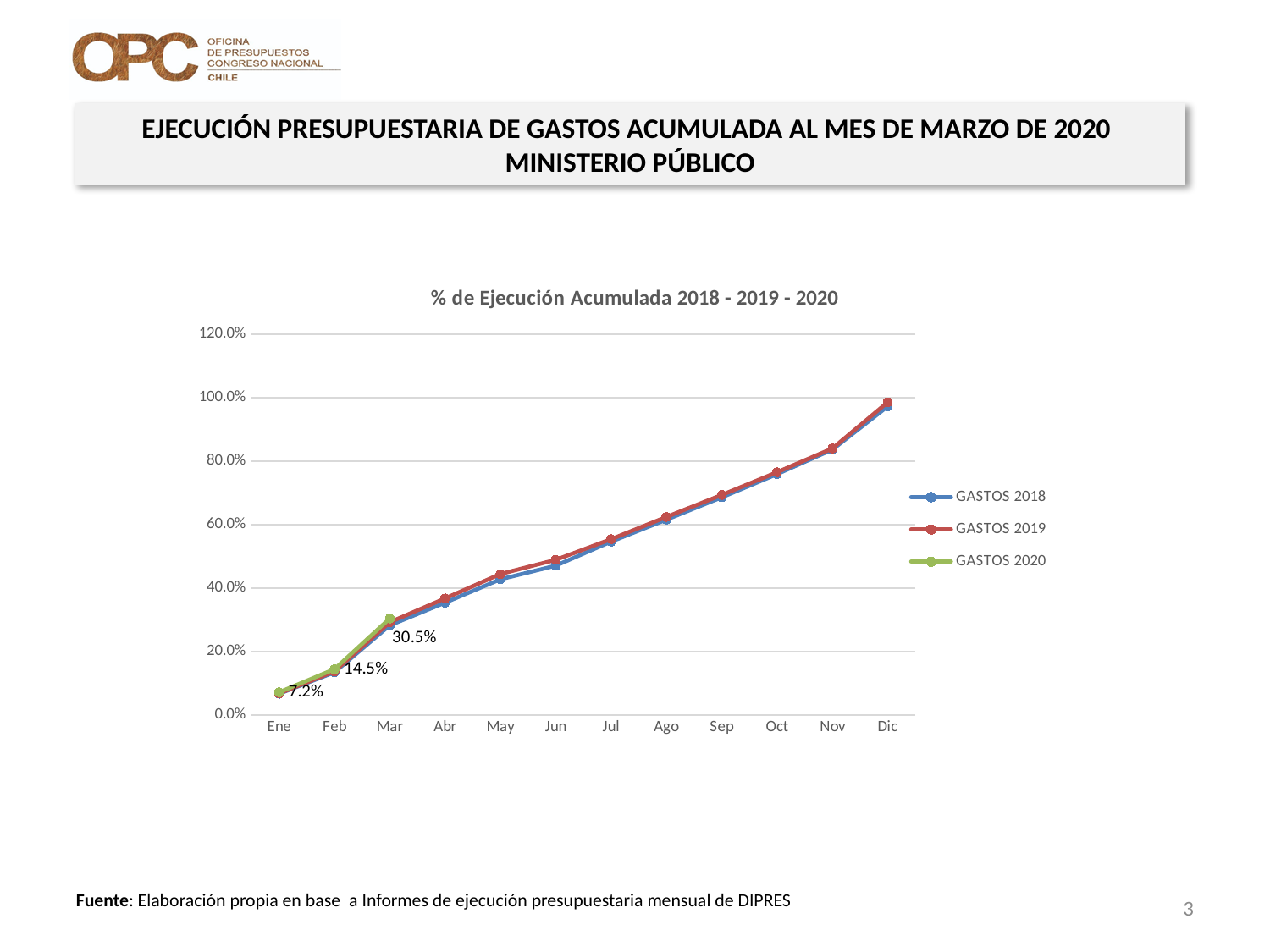
What is the value for GASTOS 2020 in Ene? 7.2% Which month has the lowest value for GASTOS 2020? Ene What is the value for GASTOS 2020 in Mar? 30.5% Which month has the highest value for GASTOS 2020? Mar What is the difference between the GASTOS 2020 values for Feb and Ene? 7.3% What is the value for GASTOS 2020 in Feb? 14.5% What is the difference between the GASTOS 2020 values for Mar and Feb? 16.0% How many months are shown on the x axis? 12 Is the value for GASTOS 2018 in Jun greater or less than 60.0%? less Is the value for GASTOS 2019 in Dic greater or less than 80.0%? greater How many series does the legend list? 3 What kind of chart is shown on the slide? Line chart